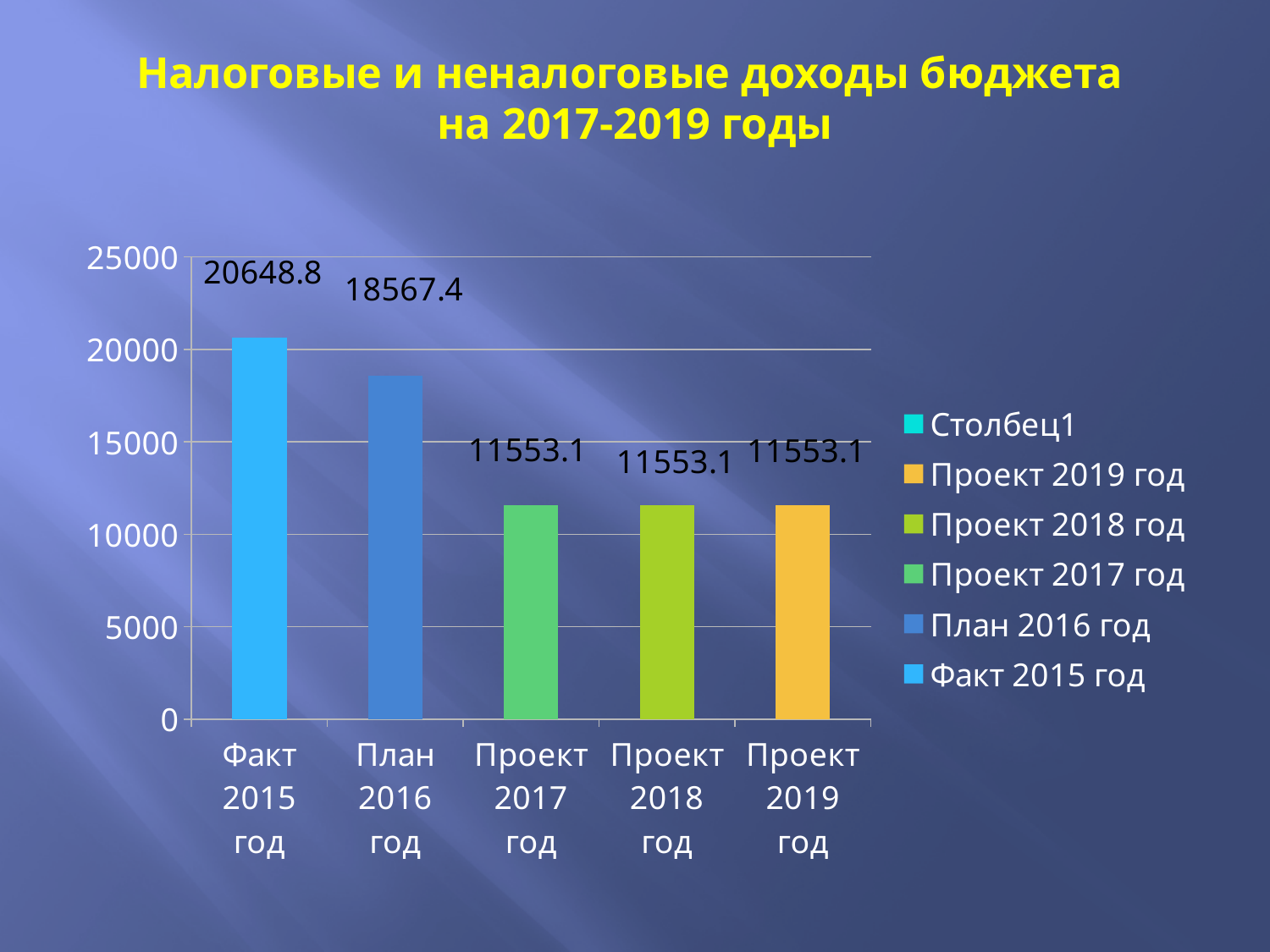
Which is larger, the value for План 2016 год or the value for Проект 2019 год? План 2016 год Is the value for Проект 2017 год greater or less than 15000? less What kind of chart is shown on the slide? bar chart How many entries does the legend list? 6 How many bars are plotted on the chart? 5 What is the difference between the values for Факт 2015 год and План 2016 год? 2081.4 What is the value for Проект 2018 год? 11553.1 What is the value for План 2016 год? 18567.4 Which category has the highest value? Факт 2015 год What is the value for Факт 2015 год? 20648.8 What is the title of the slide? Налоговые и неналоговые доходы бюджета на 2017-2019 годы What is the difference between the values for План 2016 год and Проект 2017 год? 7014.3